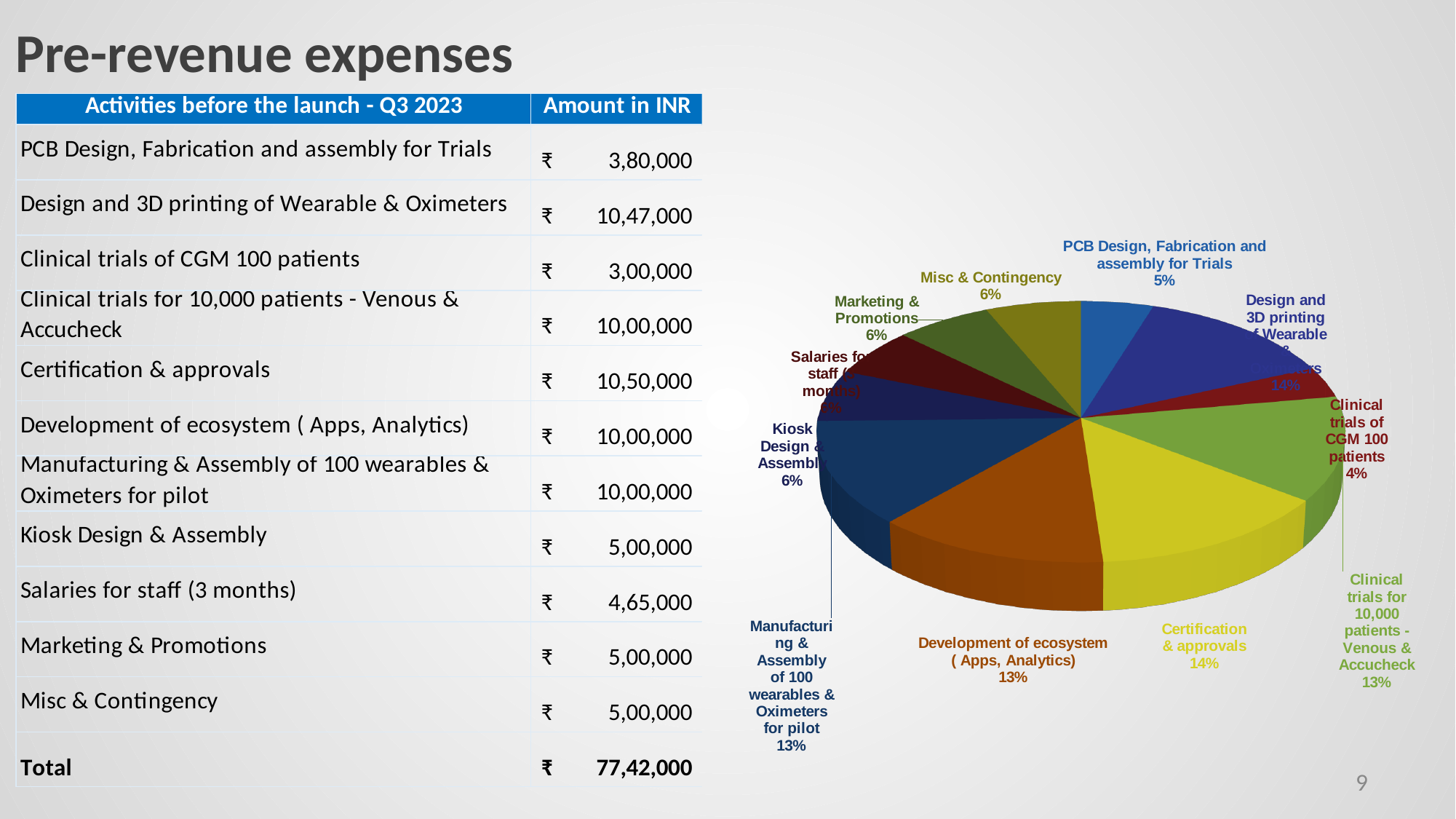
What percentage is labelled for Misc & Contingency in the pie chart? 6% What percentage is shown for Marketing & Promotions in the pie chart? 6% What share of the pie chart is Clinical trials for 10,000 patients - Venous & Accucheck? 13% What percentage is shown for PCB Design, Fabrication and assembly for Trials in the pie chart? 5% What share of the pie chart does Certification & approvals represent? 14% How many slices does the pie chart have? 11 What share of the pie chart is Clinical trials of CGM 100 patients? 4% Which has a larger share in the pie chart: Certification & approvals or Kiosk Design & Assembly? Certification & approvals What percentage does the pie chart show for Development of ecosystem ( Apps, Analytics)? 13% Which slice of the pie chart has the smallest share? Clinical trials of CGM 100 patients What is the difference in percentage points between Certification & approvals and PCB Design, Fabrication and assembly for Trials in the pie chart? 9% What kind of chart is shown on the slide? pie chart